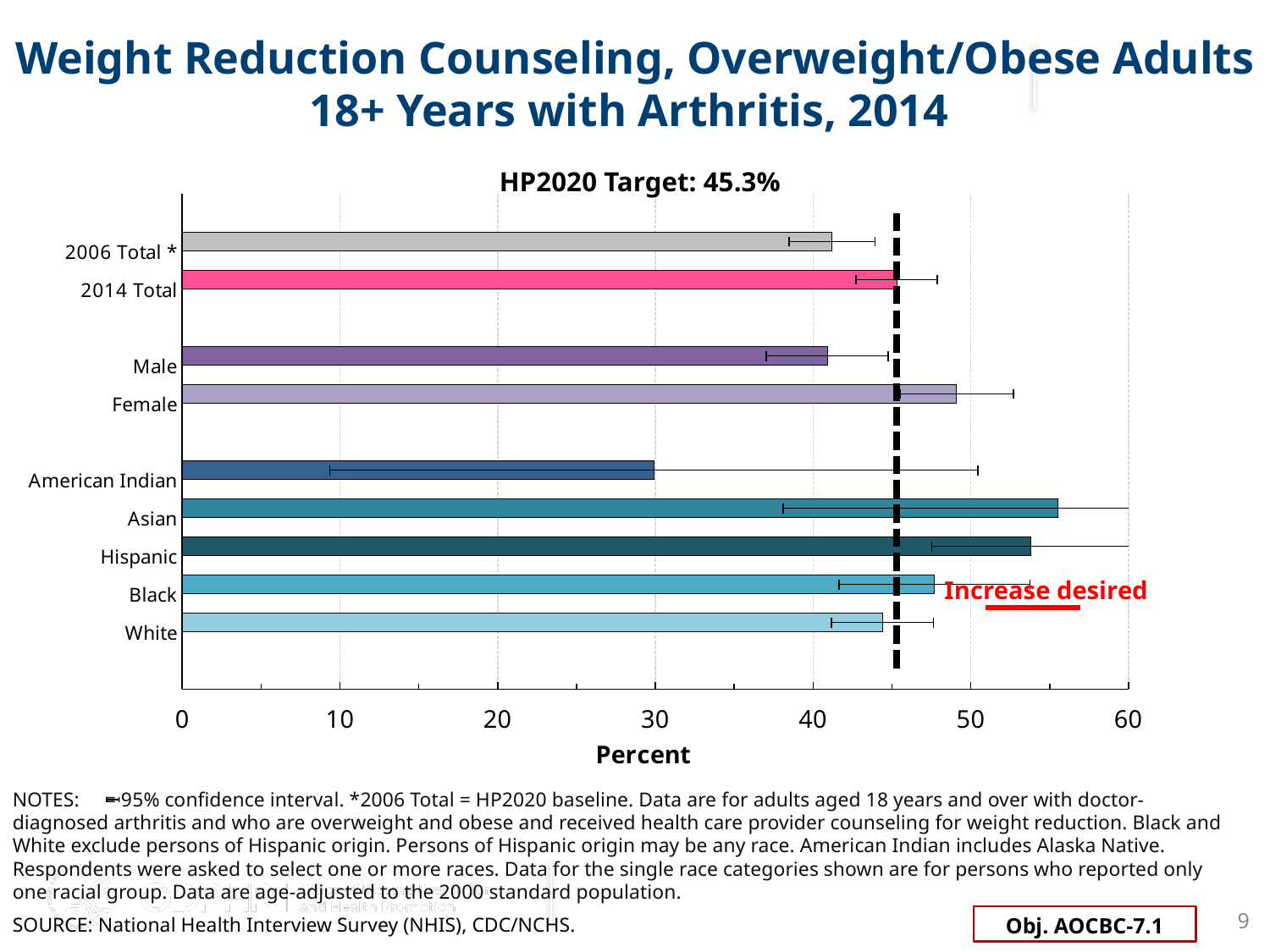
What kind of chart is shown on the slide? bar chart Which is larger, the value for Asian or the value for Black? Asian What is the HP2020 Target value shown above the chart? 45.3% What is the label of the x axis? Percent Which category has the lowest value in the chart? American Indian How many categories (bars) are plotted in the chart? 9 Is the value for Male greater or less than 50? less Is the value for American Indian greater or less than 40? less Is the value for Hispanic greater or less than 50? greater Which is larger, the value for White or the value for American Indian? White Which is larger, the value for Female or the value for Male? Female